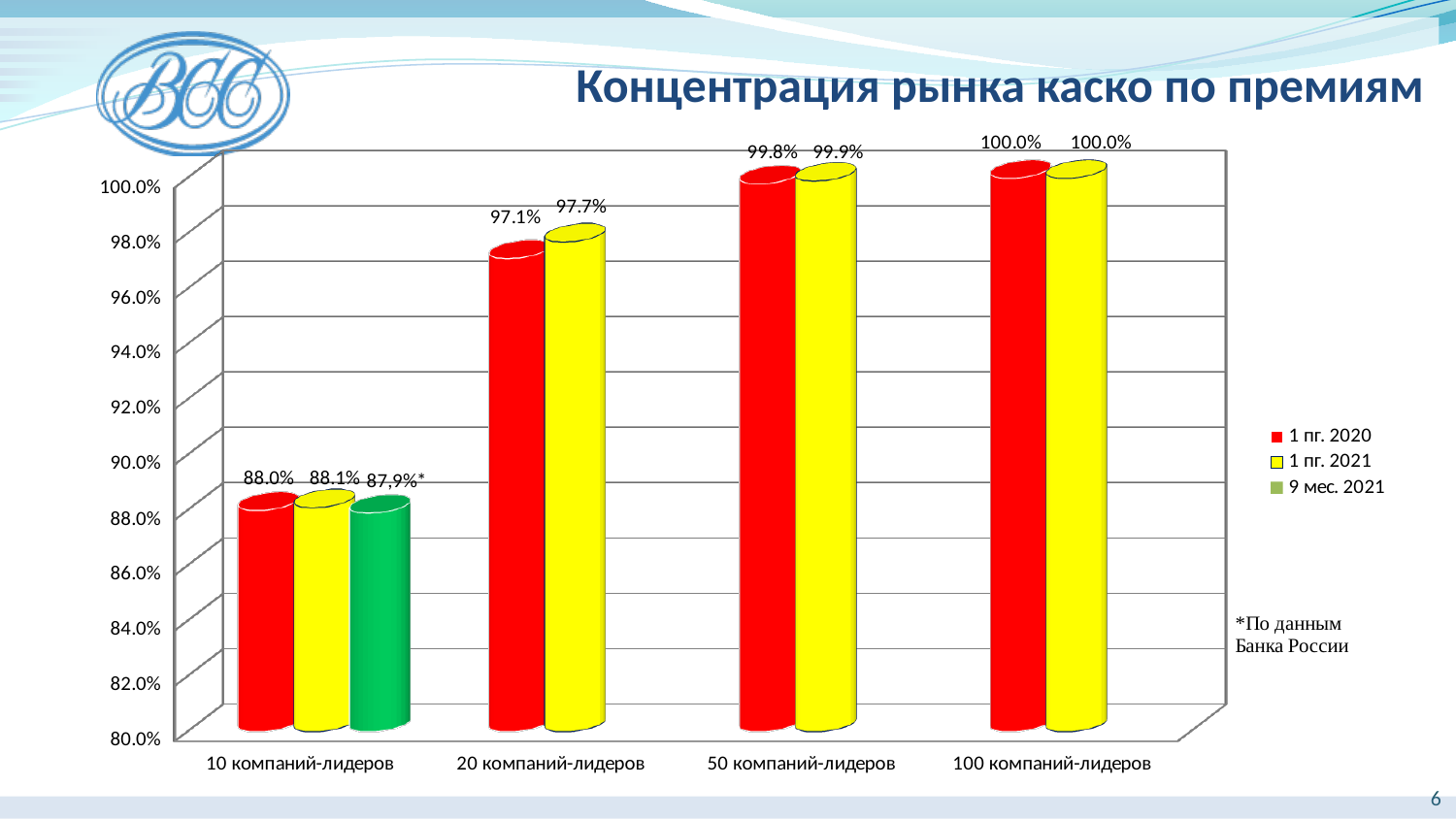
What is the value for 50 компаний-лидеров in the 1 пг. 2020 series? 99.8% What is the value for 20 компаний-лидеров in the 1 пг. 2021 series? 97.7% Which is larger for 50 компаний-лидеров: the 1 пг. 2020 value or the 1 пг. 2021 value? 1 пг. 2021 What kind of chart is shown on the slide? Bar chart What is the value for 10 компаний-лидеров in the 9 мес. 2021 series? 87,9%* Which category has the lowest value in the 1 пг. 2021 series? 10 компаний-лидеров What is the title of the chart? Концентрация рынка каско по премиям How many series does the legend list? 3 What is the difference between the 1 пг. 2021 and 1 пг. 2020 values for 20 компаний-лидеров? 0.6% How many categories are shown on the x axis? 4 What is the value for 10 компаний-лидеров in the 1 пг. 2020 series? 88.0% Do the 1 пг. 2020 values rise or fall from 10 компаний-лидеров to 100 компаний-лидеров? Rise